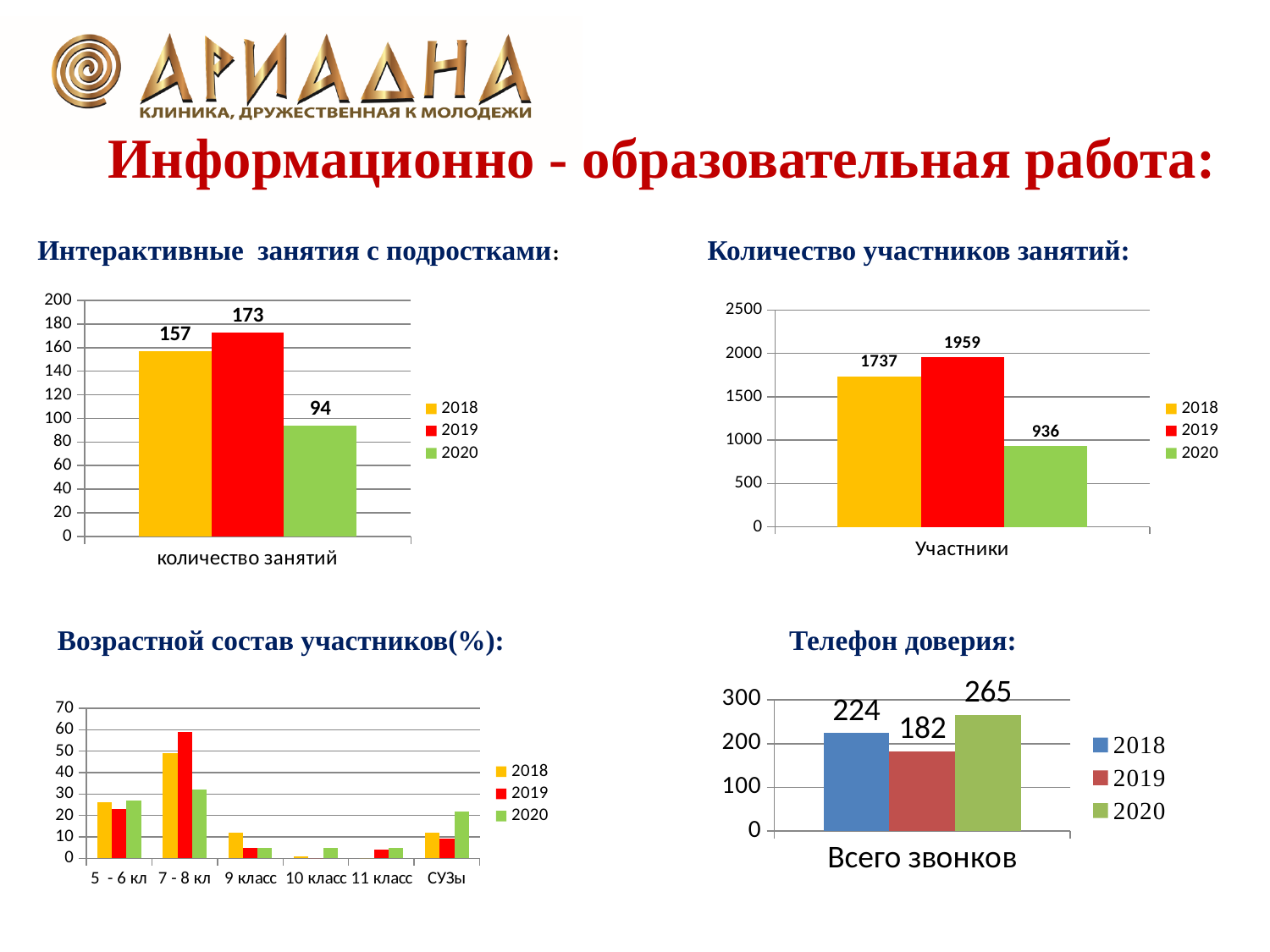
In the chart 'Интерактивные занятия с подростками', which year has the lowest value? 2020 In the chart 'Телефон доверия', what is the value for 2019? 182 In the chart 'Количество участников занятий', what is the value for 2020? 936 In the chart 'Телефон доверия', what is the difference between the 2020 and 2018 values? 41 In the chart 'Возрастной состав участников(%)', how many categories are shown on the x axis? 6 In the chart 'Интерактивные занятия с подростками', what is the value for 2019? 173 In the chart 'Возрастной состав участников(%)', is the value for 7 - 8 кл in 2019 greater or less than 50? greater In the chart 'Количество участников занятий', which year has the highest value? 2019 In the chart 'Телефон доверия', which is larger, the value for 2018 or the value for 2020? 2020 How many series does the legend of the chart 'Возрастной состав участников(%)' list? 3 In the chart 'Интерактивные занятия с подростками', what is the difference between the 2019 and 2018 values? 16 In the chart 'Количество участников занятий', what is the difference between the 2019 and 2020 values? 1023